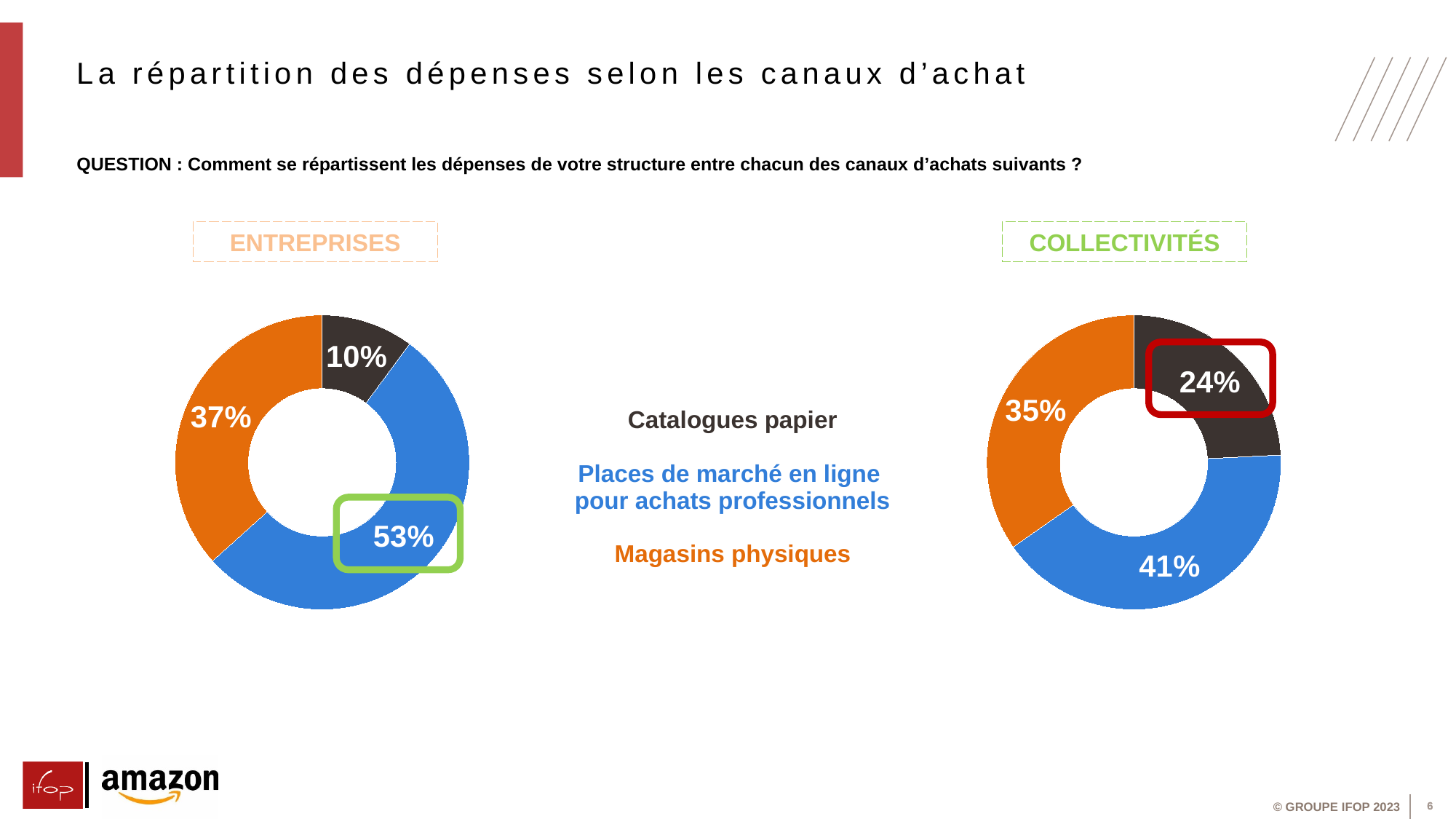
How many purchasing channels are shown in the ENTREPRISES chart? 3 In the COLLECTIVITÉS chart, what share of spending goes to Magasins physiques? 35% In the ENTREPRISES chart, what is the difference between the shares for Magasins physiques and Catalogues papier? 27% In the COLLECTIVITÉS chart, which purchasing channel has the smallest share? Catalogues papier In the COLLECTIVITÉS chart, what share of spending goes to Catalogues papier? 24% In the ENTREPRISES chart, what share of spending goes to Places de marché en ligne pour achats professionnels? 53% In the COLLECTIVITÉS chart, what is the difference between the shares for Places de marché en ligne pour achats professionnels and Magasins physiques? 6% Which chart shows a larger share for Catalogues papier, ENTREPRISES or COLLECTIVITÉS? COLLECTIVITÉS What kind of chart is used for the COLLECTIVITÉS data? Doughnut chart In the ENTREPRISES chart, which purchasing channel has the largest share? Places de marché en ligne pour achats professionnels Which colour represents Magasins physiques in the charts? Orange In the ENTREPRISES chart, what share of spending goes to Catalogues papier? 10%